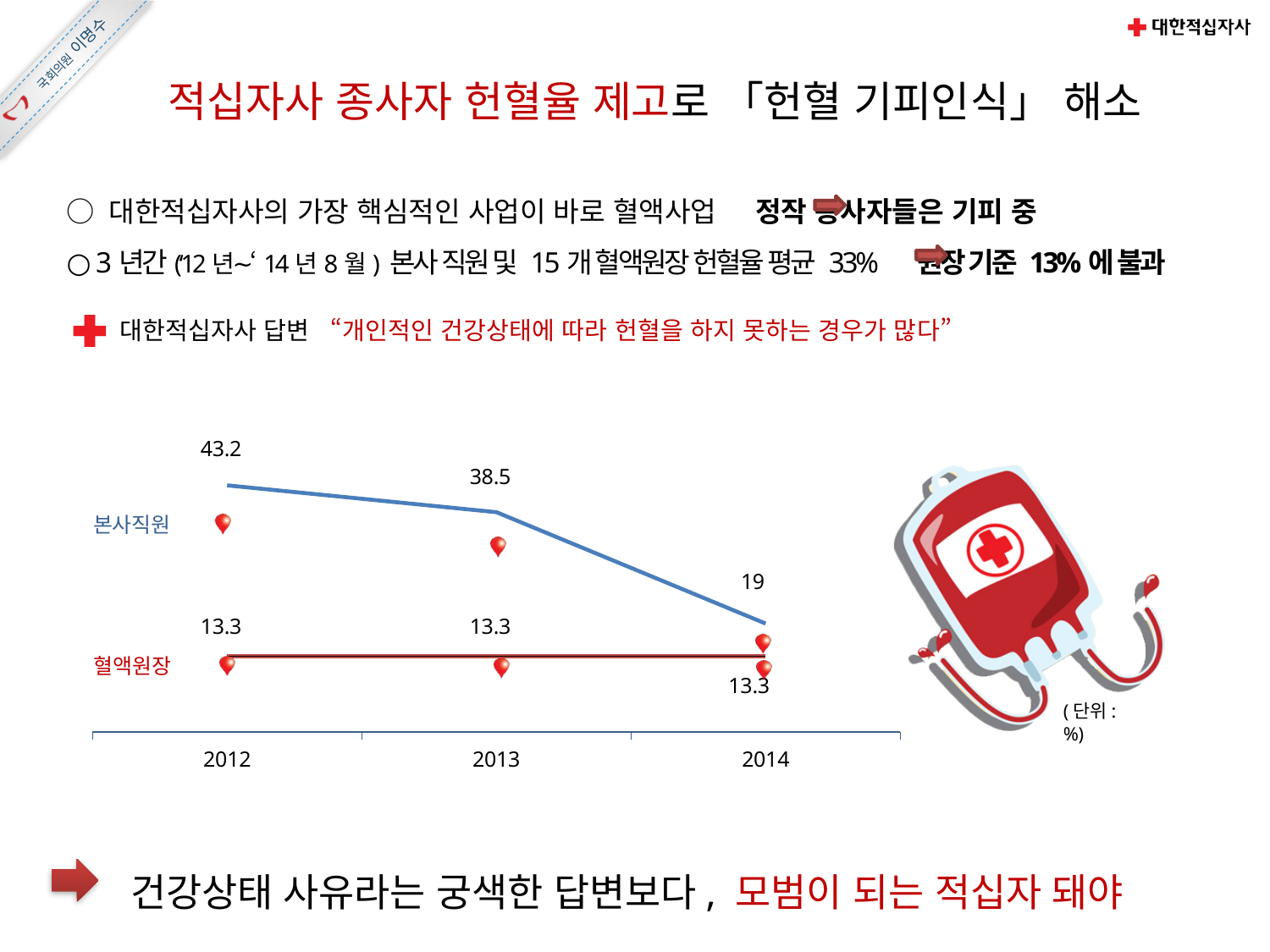
What type of chart is shown on the slide? line chart What is the value for 본사직원 in 2012? 43.2 What is the value for 본사직원 in 2013? 38.5 Which is larger in 2014, the 본사직원 value or the 혈액원장 value? 본사직원 In which year is the 본사직원 value lowest? 2014 What is the value for 본사직원 in 2014? 19 What unit is indicated for the chart values? % In which year is the 본사직원 value highest? 2012 How many years are shown on the x axis of the chart? 3 What is the value for 혈액원장 in 2013? 13.3 Does the 본사직원 line rise or fall from 2012 to 2014? fall What is the difference between the 본사직원 values in 2012 and 2014? 24.2